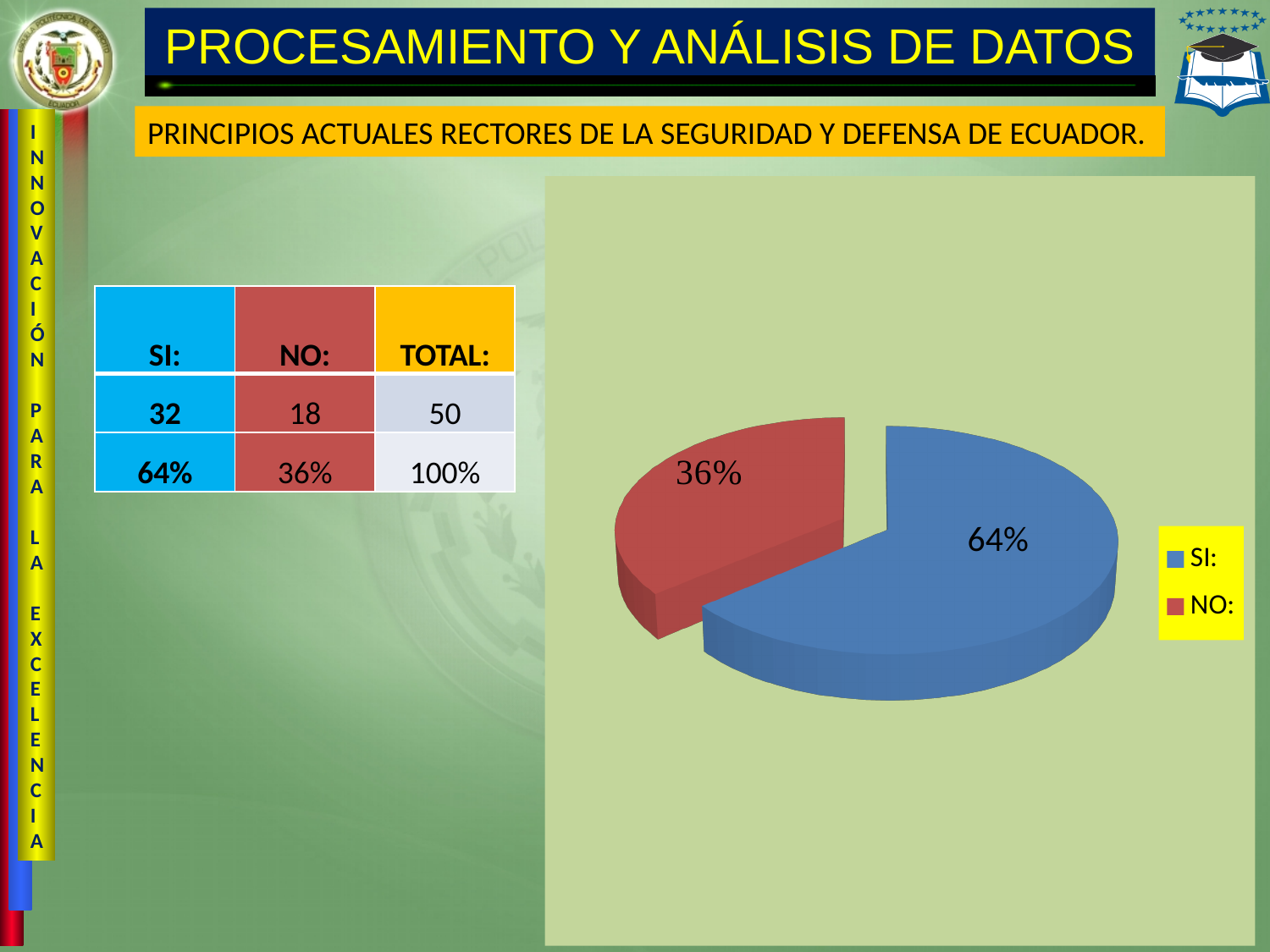
Which slice of the pie chart is the largest? SI: Which slice is larger, SI: or NO:? SI: What percentage does the SI: slice of the pie chart show? 64% What is the difference in percentage points between the SI: and NO: slices? 28 Which slice of the pie chart is the smallest? NO: How many slices does the pie chart have? 2 What colour is the NO: slice in the pie chart? red What kind of chart is shown on the slide? pie chart What colour is the SI: slice in the pie chart? blue What percentage does the NO: slice of the pie chart show? 36% What share of the pie does the NO: slice represent? 36% How many entries does the legend of the pie chart list? 2